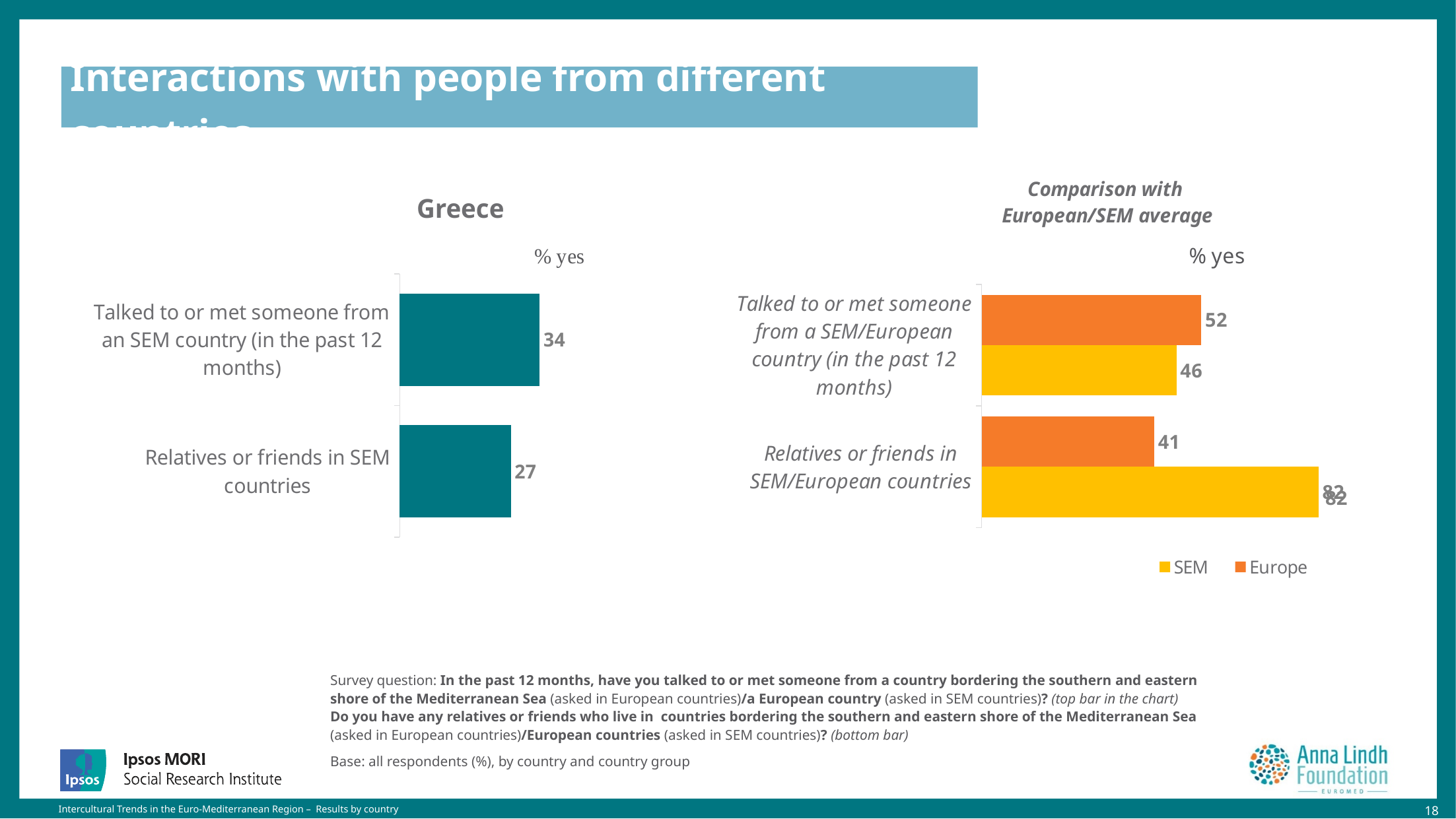
In the Greece chart, what is the difference between the two bars? 7 In the Comparison with European/SEM average chart, what is the SEM value for talked to or met someone from a SEM/European country? 46 In the Comparison with European/SEM average chart, what is the difference between the Europe and SEM values for talked to or met someone from a SEM/European country? 6 What type of chart is the Greece chart? Bar chart In the Greece chart, which category has the higher value? Talked to or met someone from an SEM country (in the past 12 months) In the Greece chart, what is the value for relatives or friends in SEM countries? 27 In the Comparison with European/SEM average chart, what is the Europe value for talked to or met someone from a SEM/European country? 52 In the Greece chart, what percentage said yes to having talked to or met someone from an SEM country in the past 12 months? 34 In the Comparison with European/SEM average chart, what is the Europe value for relatives or friends in SEM/European countries? 41 In the Comparison with European/SEM average chart, which is larger for talked to or met someone: the SEM value or the Europe value? Europe How many categories does the Greece chart show? 2 How many series does the legend of the Comparison with European/SEM average chart list? 2